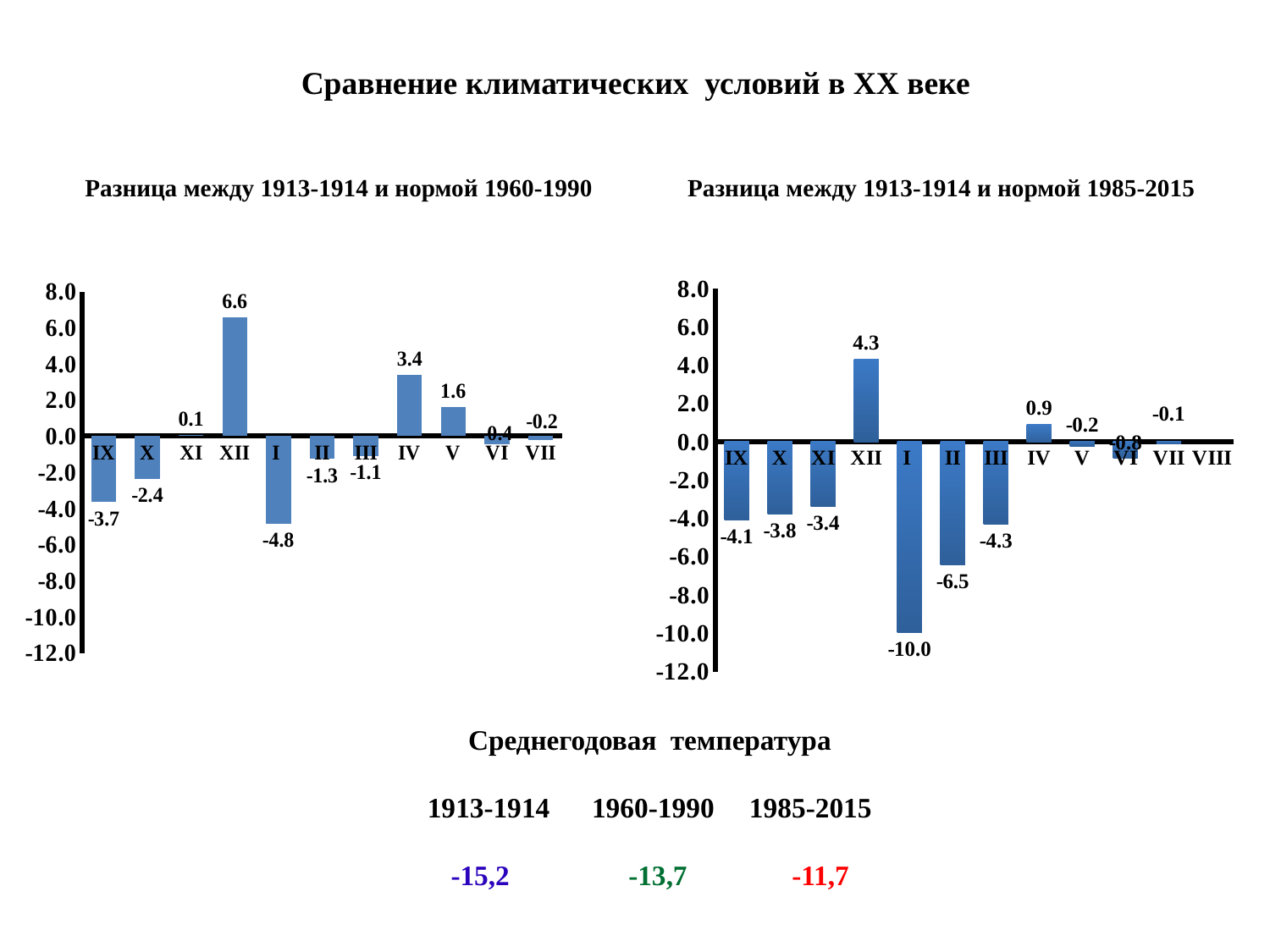
In the right chart (Разница между 1913-1914 и нормой 1985-2015), what is the value for XII? 4.3 How many months are shown on the x axis of the right chart (Разница между 1913-1914 и нормой 1985-2015)? 12 In the left chart (Разница между 1913-1914 и нормой 1960-1990), which month has the highest value? XII In the left chart (Разница между 1913-1914 и нормой 1960-1990), what is the difference between the values for XII and IV? 3.2 What type of chart is the left chart (Разница между 1913-1914 и нормой 1960-1990)? Bar chart In the left chart (Разница между 1913-1914 и нормой 1960-1990), what is the value for I? -4.8 In the left chart (Разница между 1913-1914 и нормой 1960-1990), which month has the lowest value? I In the right chart (Разница между 1913-1914 и нормой 1985-2015), what is the value for I? -10.0 In the right chart (Разница между 1913-1914 и нормой 1985-2015), which is larger, the value for IX or the value for II? IX In the left chart (Разница между 1913-1914 и нормой 1960-1990), what is the value for XII? 6.6 In the right chart (Разница между 1913-1914 и нормой 1985-2015), which month has the lowest value? I In the right chart (Разница между 1913-1914 и нормой 1985-2015), what is the difference between the values for II and III? 2.2